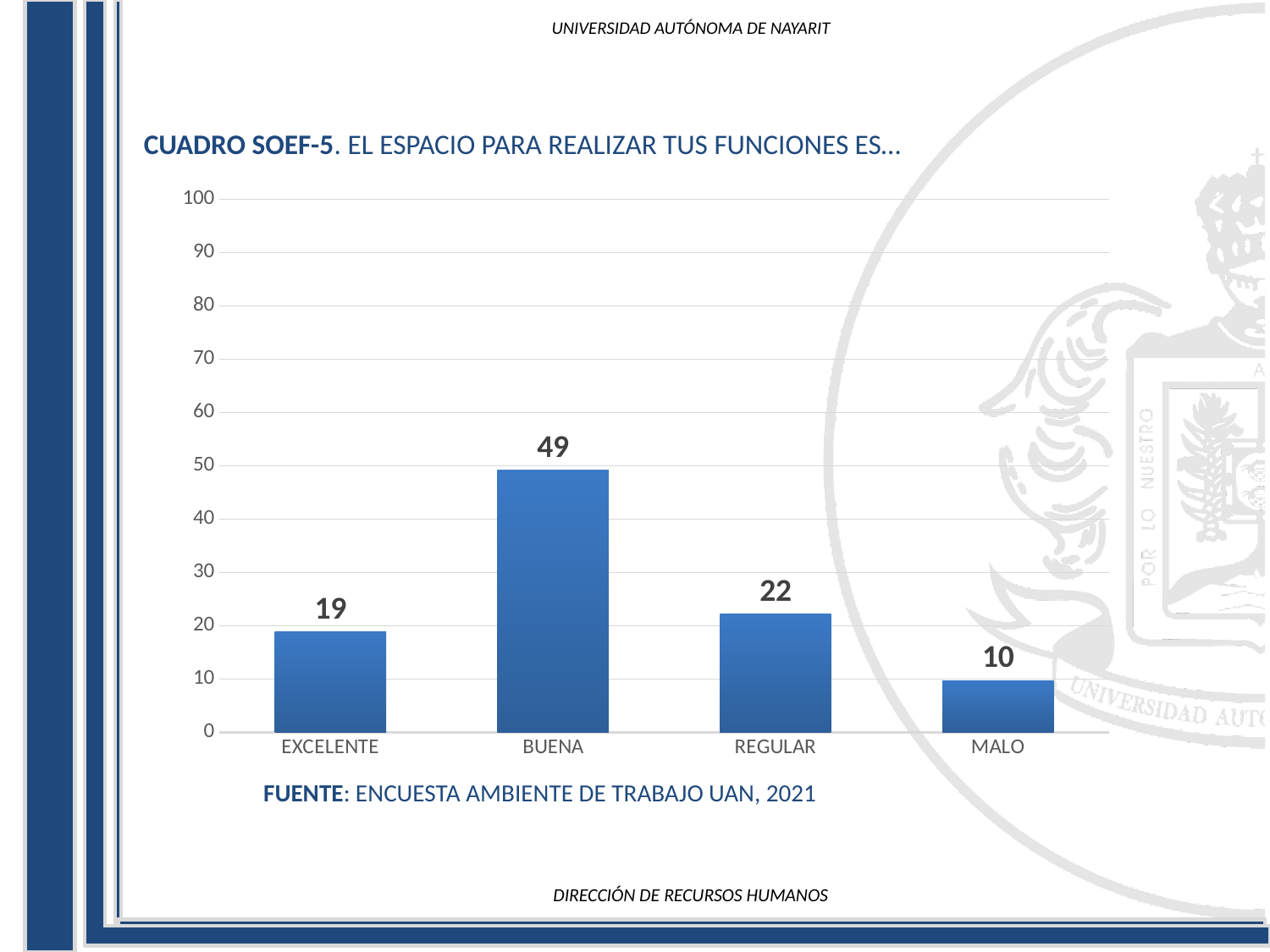
What is the difference between the values for BUENA and REGULAR? 27 What is the value for EXCELENTE? 19 What is the value for MALO? 10 Is the value for BUENA greater or less than 40? greater Which category has the highest value? BUENA What is the difference between the values for EXCELENTE and MALO? 9 Which category has the lowest value? MALO What kind of chart is shown on the slide? bar chart Which is larger, the value for REGULAR or the value for EXCELENTE? REGULAR What is the value for BUENA? 49 What is the value for REGULAR? 22 How many categories are shown on the x axis? 4